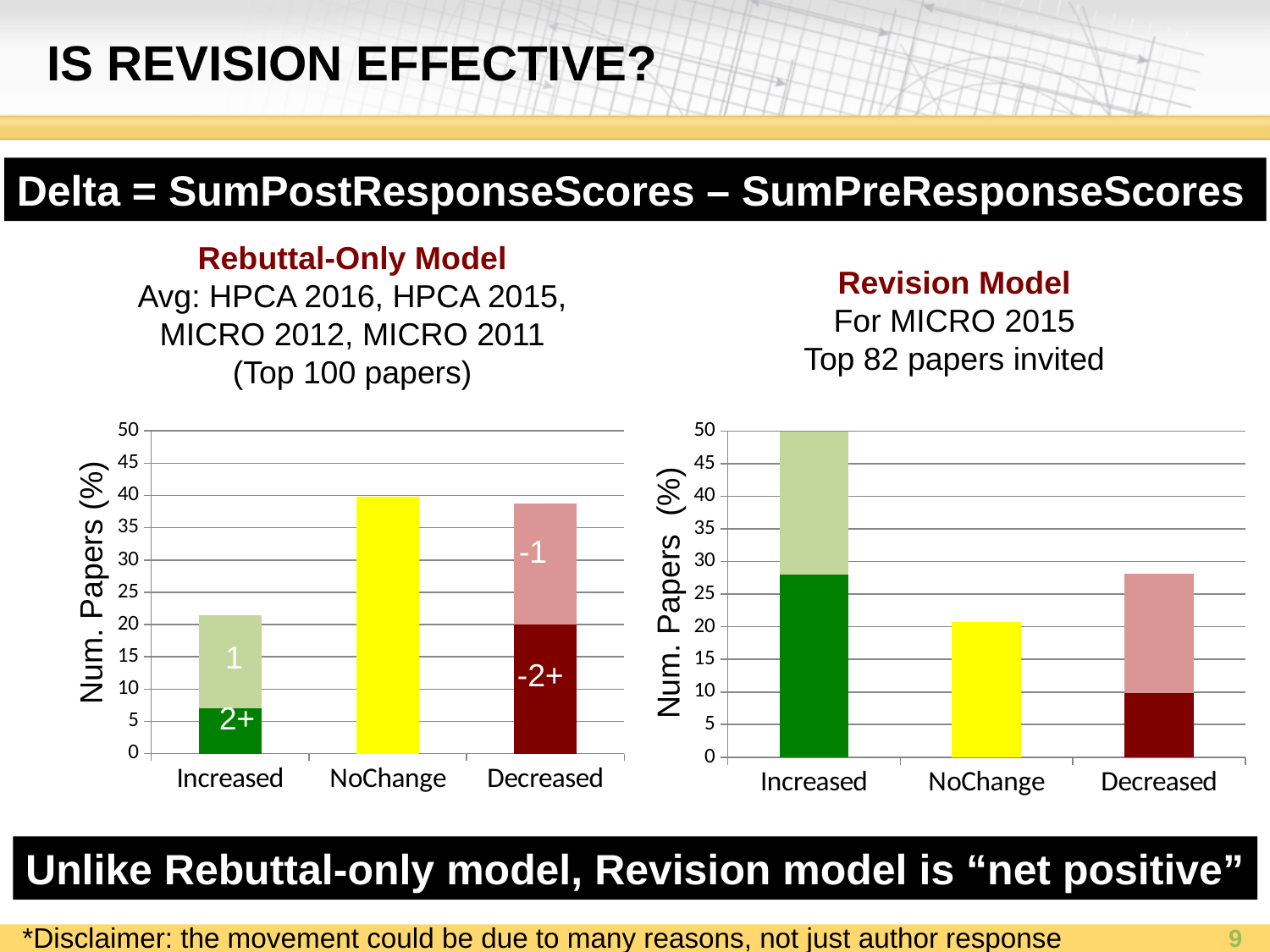
In the Revision Model chart, which category has the lowest total bar? NoChange In the Rebuttal-Only Model chart, which category has the lowest total bar? Increased How many categories are shown on the x axis of the Rebuttal-Only Model chart? 3 What kind of chart is the Revision Model chart? bar chart In the Revision Model chart, is the value for NoChange greater or less than 25? less In the Revision Model chart, which total bar is larger, Increased or Decreased? Increased In the Revision Model chart, is the total value for Increased greater or less than 45? greater In the Revision Model chart, which category has the highest total bar? Increased In the Rebuttal-Only Model chart, is the value for NoChange greater or less than 35? greater What is the y-axis label of the Rebuttal-Only Model chart? Num. Papers (%)